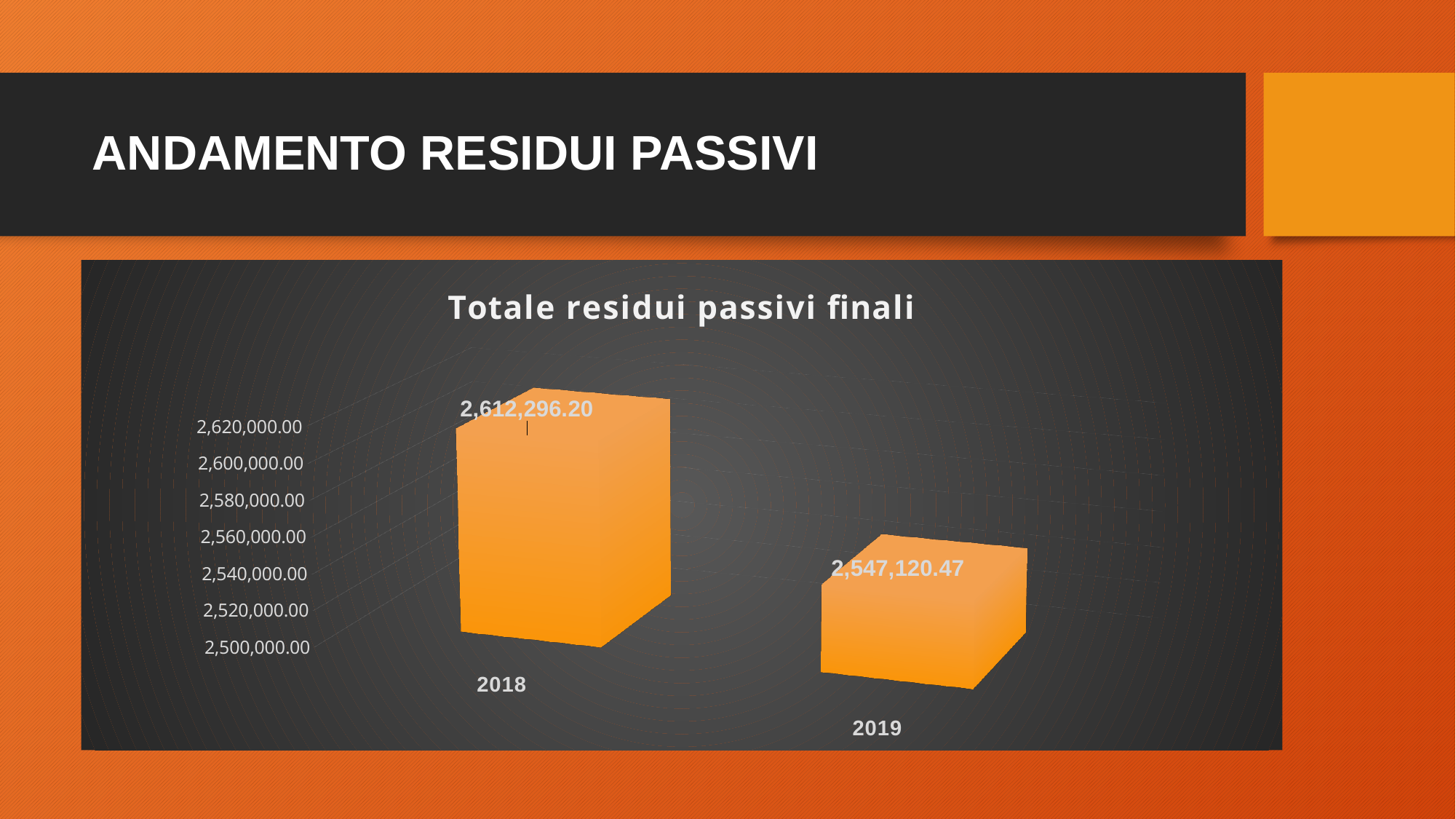
Which year has the highest value? 2018 What is the value for 2018? 2,612,296.20 Which is larger, the value for 2018 or the value for 2019? 2018 What kind of chart is shown on the slide? bar chart What is the difference between the 2018 value and the 2019 value? 65,175.73 Is the value for 2018 greater or less than 2,600,000.00? greater What is the value for 2019? 2,547,120.47 How many years are shown on the chart? 2 Is the value for 2019 greater or less than 2,560,000.00? less Do the values rise or fall from 2018 to 2019? fall Which year has the lowest value? 2019 What is the title of the chart? Totale residui passivi finali